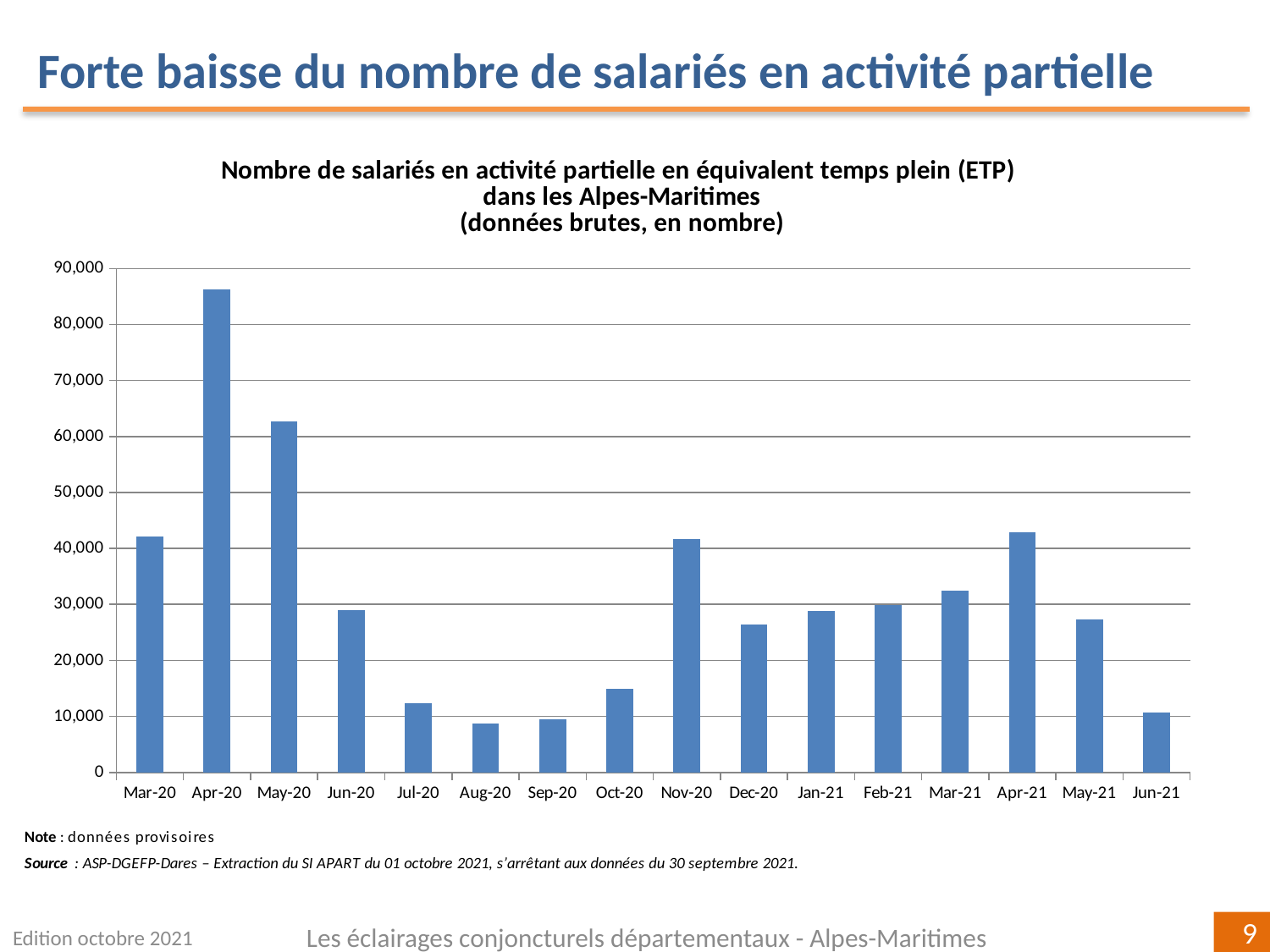
Which is larger, the value for Mar-21 or the value for Apr-21? Apr-21 Which is larger, the value for Nov-20 or the value for Dec-20? Nov-20 Is the value for May-20 greater or less than 60,000? greater Do the values rise or fall from Apr-20 to Aug-20? fall How many months are plotted on the x axis of the chart? 16 What is the title of the chart? Nombre de salariés en activité partielle en équivalent temps plein (ETP) dans les Alpes-Maritimes (données brutes, en nombre) What kind of chart is shown on the slide? bar chart Which month has the highest number of salariés en activité partielle? Apr-20 Is the value for Apr-21 greater or less than 40,000? greater Is the value for Apr-20 greater or less than 80,000? greater